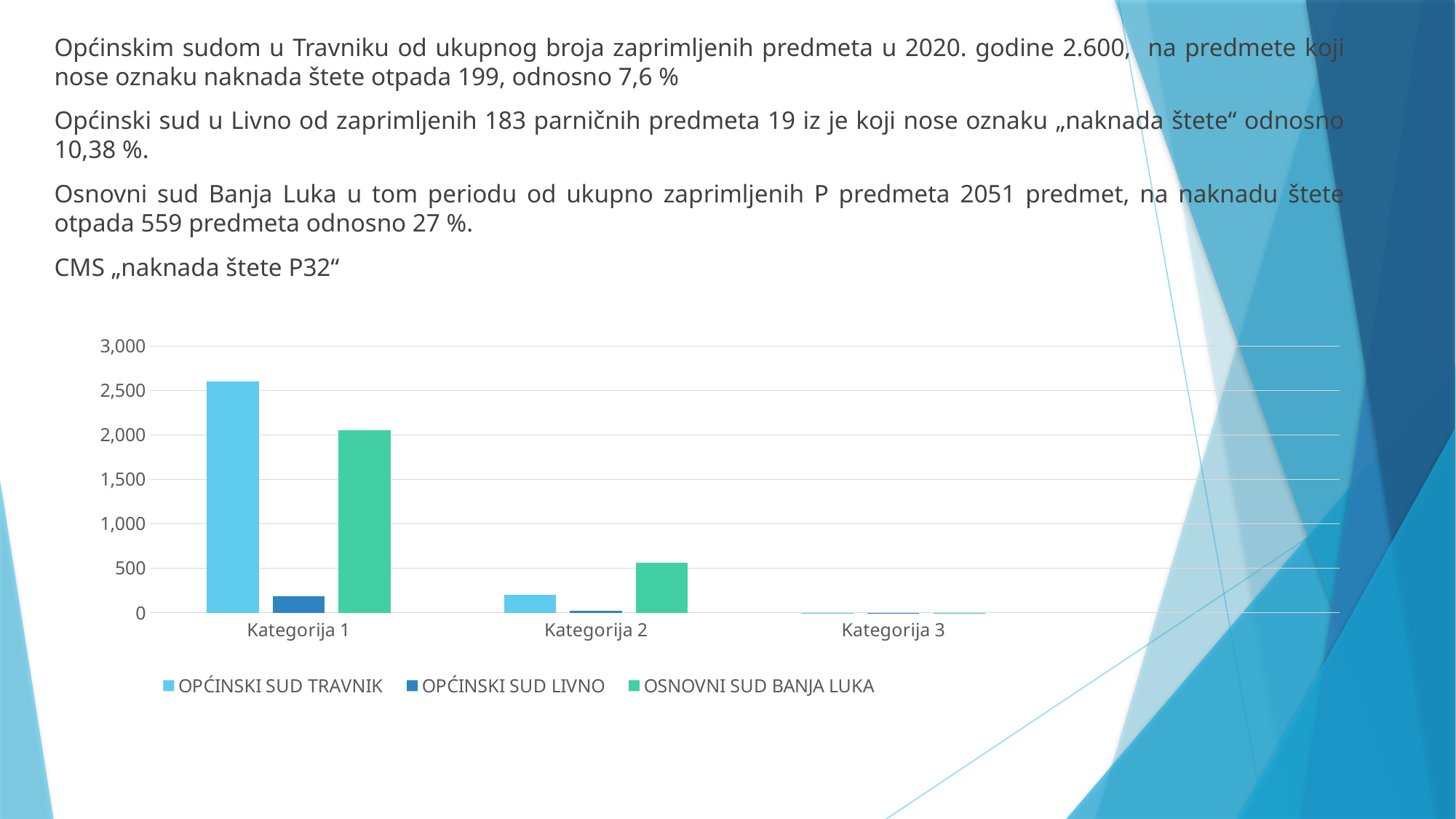
Is the value for OSNOVNI SUD BANJA LUKA in Kategorija 1 greater or less than 2,500? less In Kategorija 1, which series has the lowest bar? OPĆINSKI SUD LIVNO Do the values for OPĆINSKI SUD TRAVNIK rise or fall from Kategorija 1 to Kategorija 3? fall What colour are the bars for OSNOVNI SUD BANJA LUKA in the chart? green How many categories are shown on the x axis of the chart? 3 In Kategorija 1, which series has the highest bar? OPĆINSKI SUD TRAVNIK In Kategorija 1, which is larger: the bar for OPĆINSKI SUD TRAVNIK or the bar for OSNOVNI SUD BANJA LUKA? OPĆINSKI SUD TRAVNIK Is the value for OSNOVNI SUD BANJA LUKA in Kategorija 2 greater or less than 500? greater How many series does the chart legend list? 3 Is the value for OPĆINSKI SUD TRAVNIK in Kategorija 1 greater or less than 2,500? greater In Kategorija 2, which series has the highest bar? OSNOVNI SUD BANJA LUKA What kind of chart is shown on the slide? bar chart